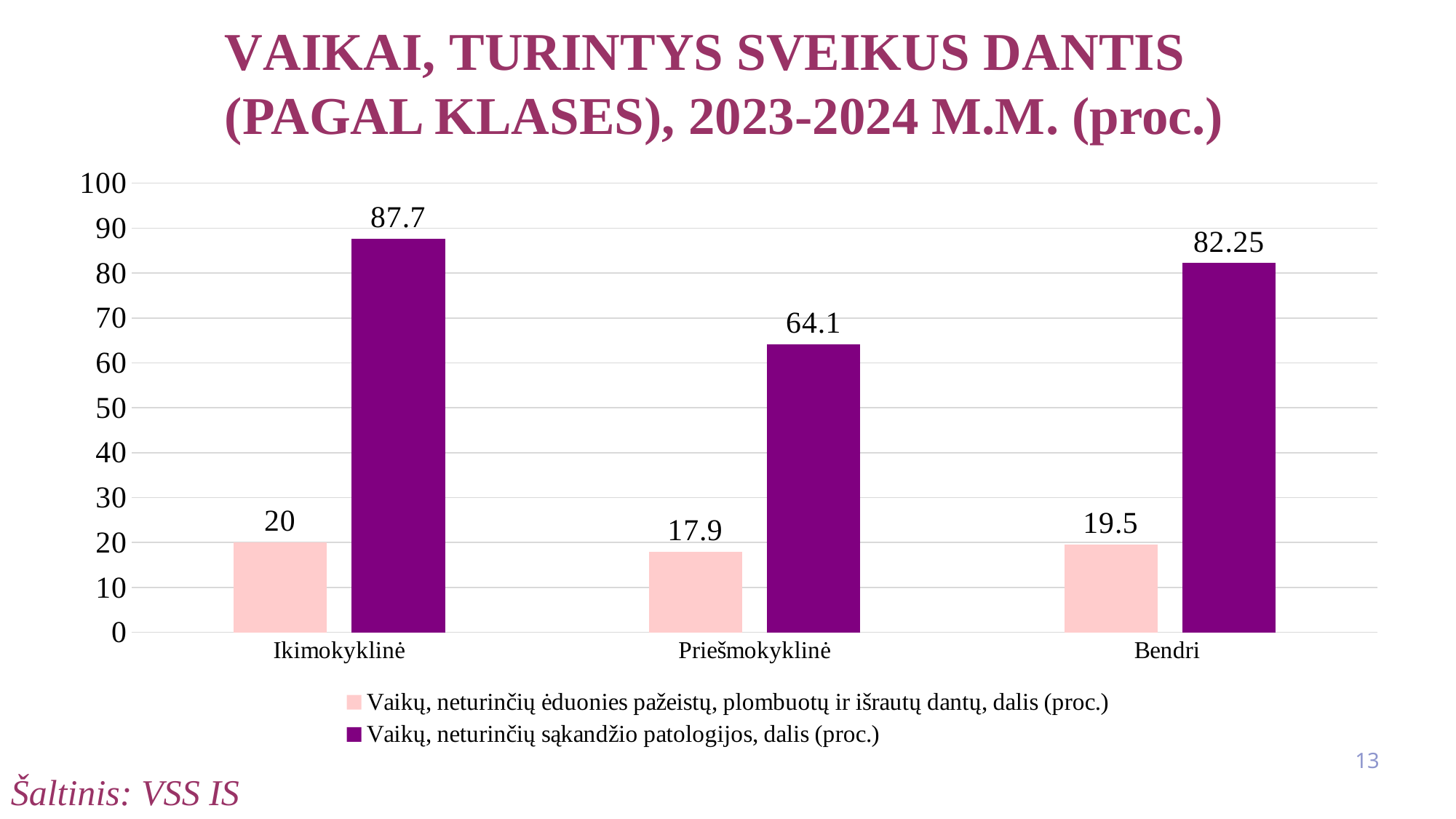
What is the value for Ikimokyklinė in the series 'Vaikų, neturinčių sąkandžio patologijos, dalis (proc.)'? 87.7 Is the value for Ikimokyklinė in the series 'Vaikų, neturinčių sąkandžio patologijos, dalis (proc.)' greater or less than 80? greater How many categories are shown on the x axis? 3 What colour are the bars for the series 'Vaikų, neturinčių sąkandžio patologijos, dalis (proc.)'? Purple What kind of chart is shown on the slide? Bar chart How many series does the legend list? 2 Which is larger: the 'Vaikų, neturinčių sąkandžio patologijos' value for Priešmokyklinė or for Bendri? Bendri Which category has the highest value in the series 'Vaikų, neturinčių sąkandžio patologijos, dalis (proc.)'? Ikimokyklinė Which category has the lowest value in the series 'Vaikų, neturinčių ėduonies pažeistų, plombuotų ir išrautų dantų, dalis (proc.)'? Priešmokyklinė What is the difference between the two series values for Priešmokyklinė? 46.2 What is the value for Bendri in the series 'Vaikų, neturinčių sąkandžio patologijos, dalis (proc.)'? 82.25 What is the value for Priešmokyklinė in the series 'Vaikų, neturinčių ėduonies pažeistų, plombuotų ir išrautų dantų, dalis (proc.)'? 17.9